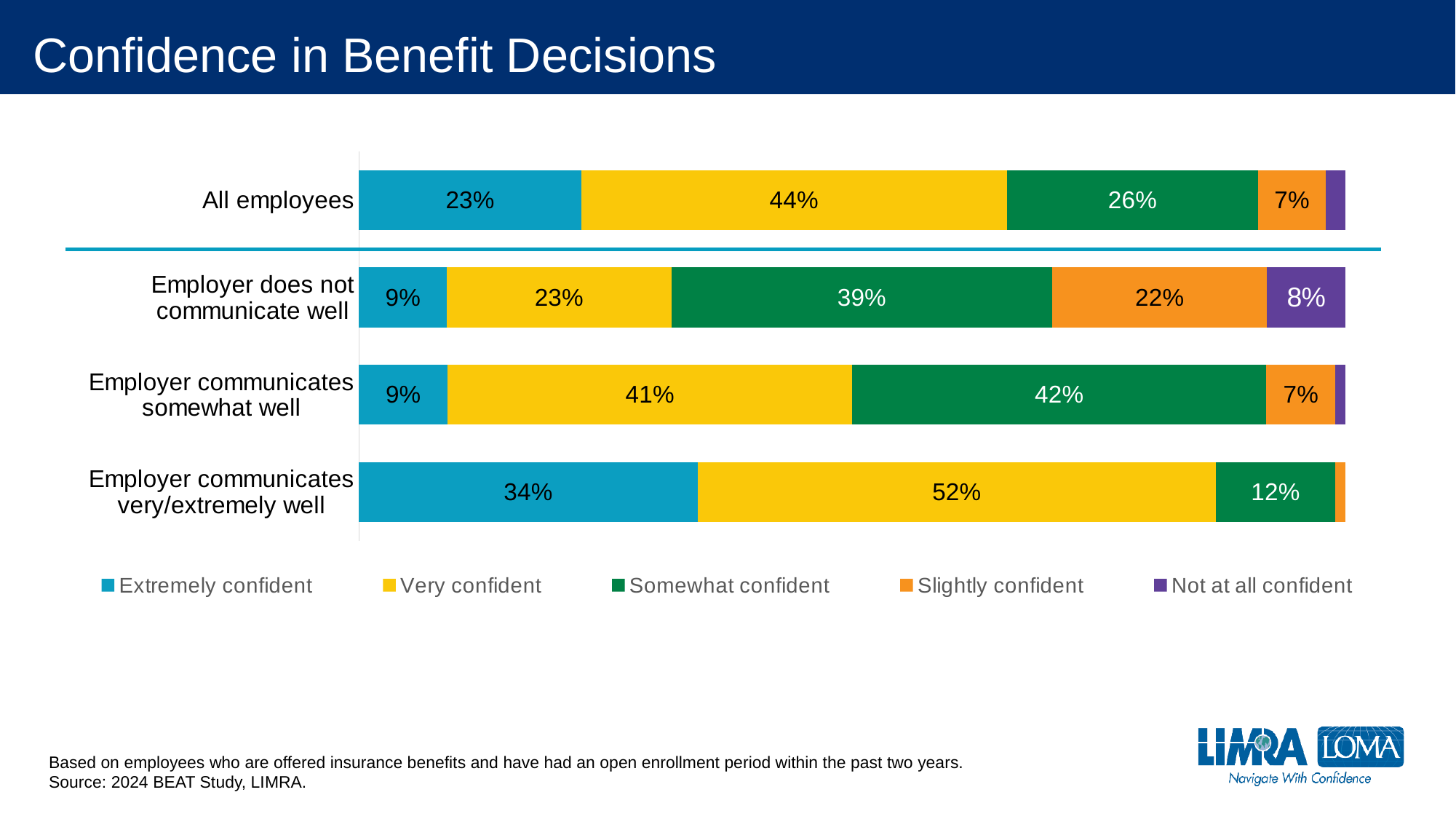
What is the difference between the very confident share for employees whose employer communicates very/extremely well and for all employees? 8 percentage points How many confidence levels does the legend list? 5 How many employee groups (bars) are shown in the chart? 4 What percentage of employees whose employer communicates somewhat well are slightly confident? 7% Which employee group has the lowest share of very confident employees? Employer does not communicate well Which employee group has the highest share of extremely confident employees? Employer communicates very/extremely well Which colour represents 'Not at all confident' in the chart? Purple What percentage of employees whose employer does not communicate well are somewhat confident? 39% Which is larger: the somewhat confident share for employees whose employer communicates somewhat well, or for employees whose employer does not communicate well? Employer communicates somewhat well What percentage of employees whose employer communicates very/extremely well are extremely confident? 34% What percentage of all employees are very confident in their benefit decisions? 44% What type of chart is shown on the slide? Stacked bar chart